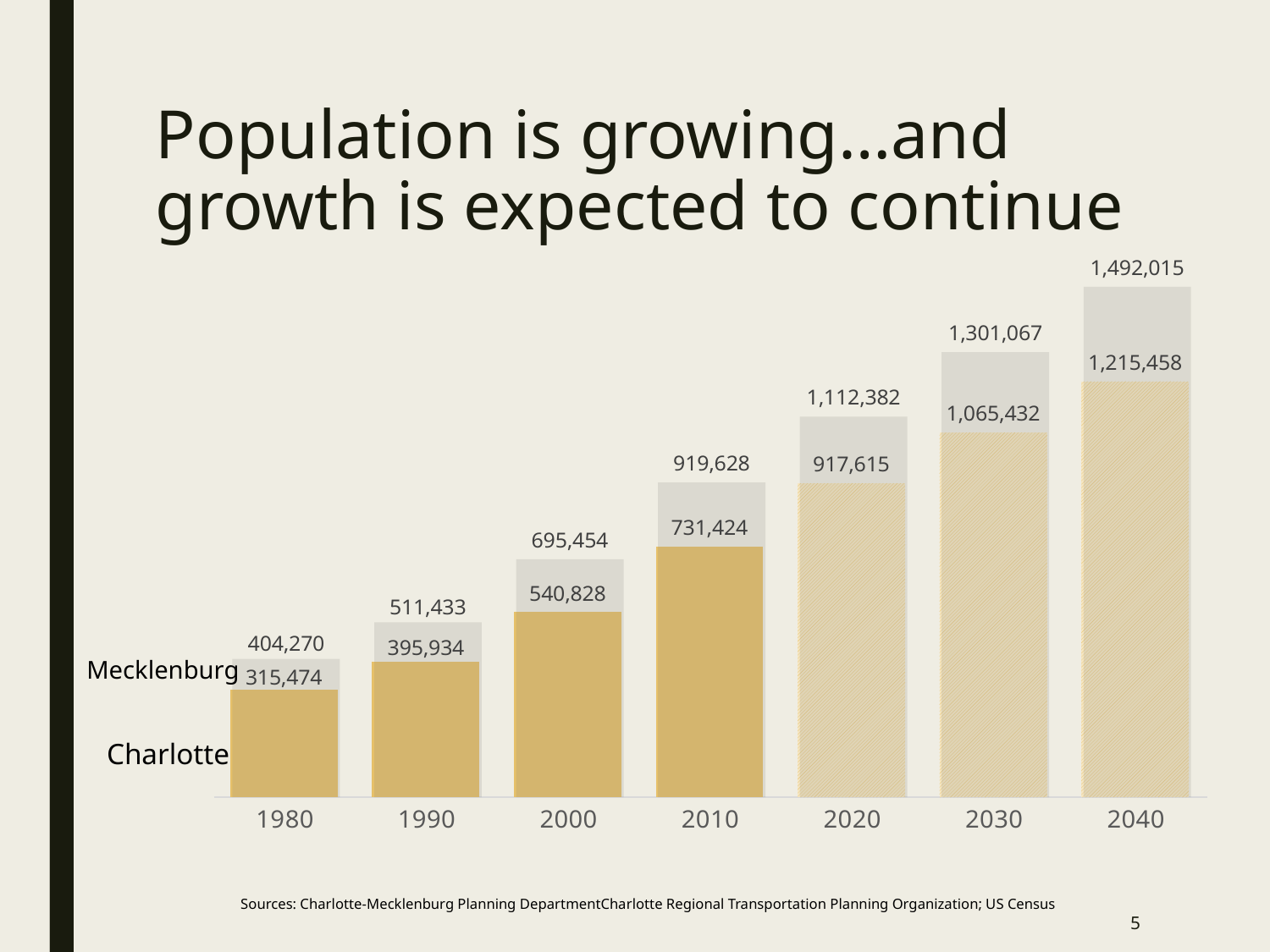
How many years are shown on the x axis of the chart? 7 In which year is the Charlotte population value the lowest? 1980 What is the Charlotte population value shown for 1990? 395,934 What is the Charlotte population value shown for 2010? 731,424 What is the difference between the Mecklenburg and Charlotte values in 2010? 188,204 Do the Charlotte population values rise or fall from 1980 to 2040? Rise What kind of chart is shown on the slide? Bar chart Which is larger, the Charlotte value for 2020 or the Mecklenburg value for 2000? Charlotte value for 2020 What is the Mecklenburg population value shown for 2040? 1,492,015 What is the Mecklenburg population value shown for 2000? 695,454 In which year is the Mecklenburg population value the highest? 2040 What is the difference between the Mecklenburg and Charlotte values in 1980? 88,796